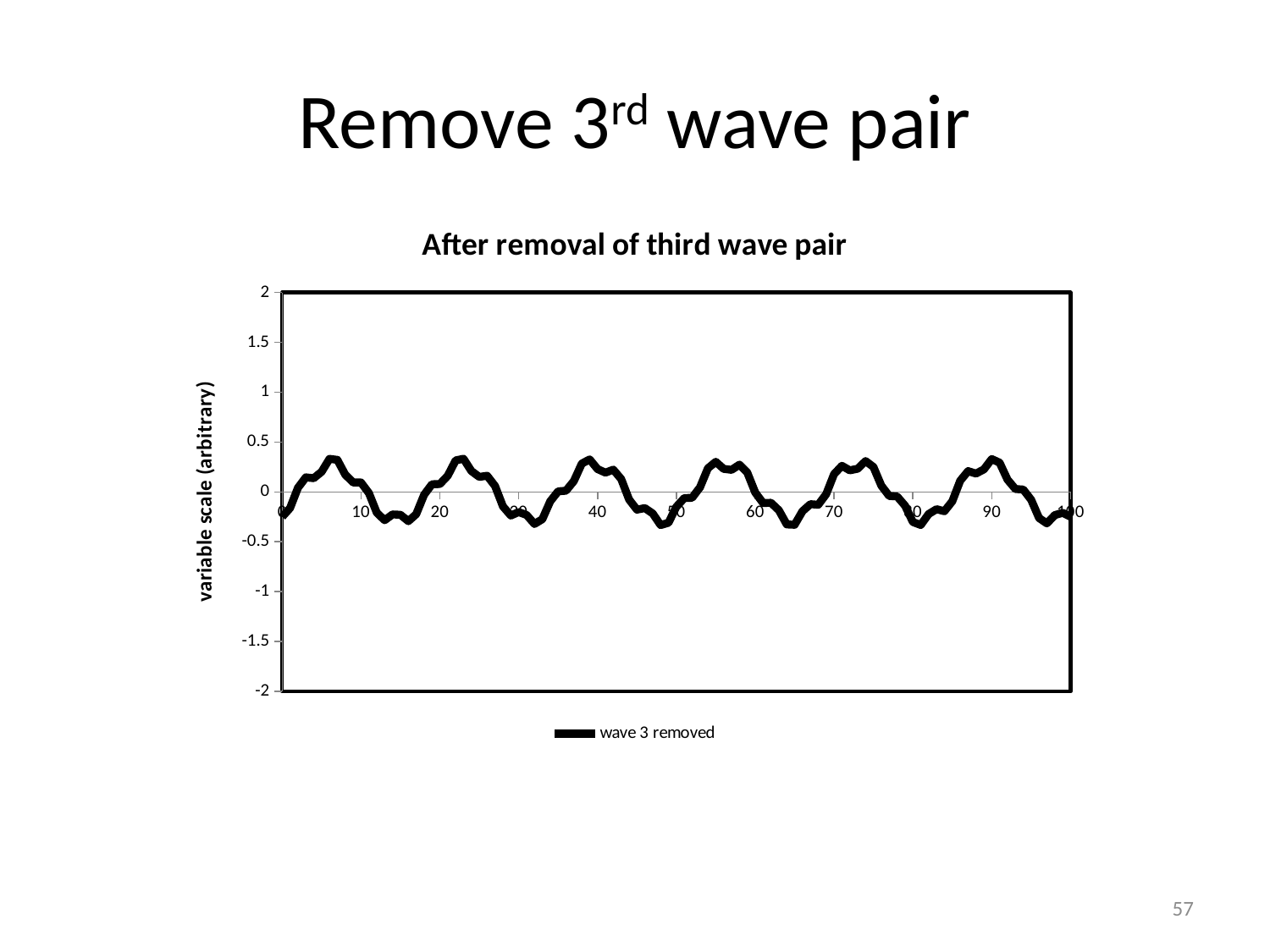
Is the highest value reached by the 'wave 3 removed' line greater or less than 0? greater Is the lowest value reached by the 'wave 3 removed' line greater or less than -1? greater What kind of chart is shown on the slide? line chart What is the maximum value shown on the vertical axis? 2 What is the title of the chart? After removal of third wave pair How many series does the legend list? 1 What is the legend entry for the plotted series? wave 3 removed Is the highest value reached by the 'wave 3 removed' line greater or less than 0.5? less Does the 'wave 3 removed' line show a steady rise, a steady fall, or an oscillation along the x axis? oscillation